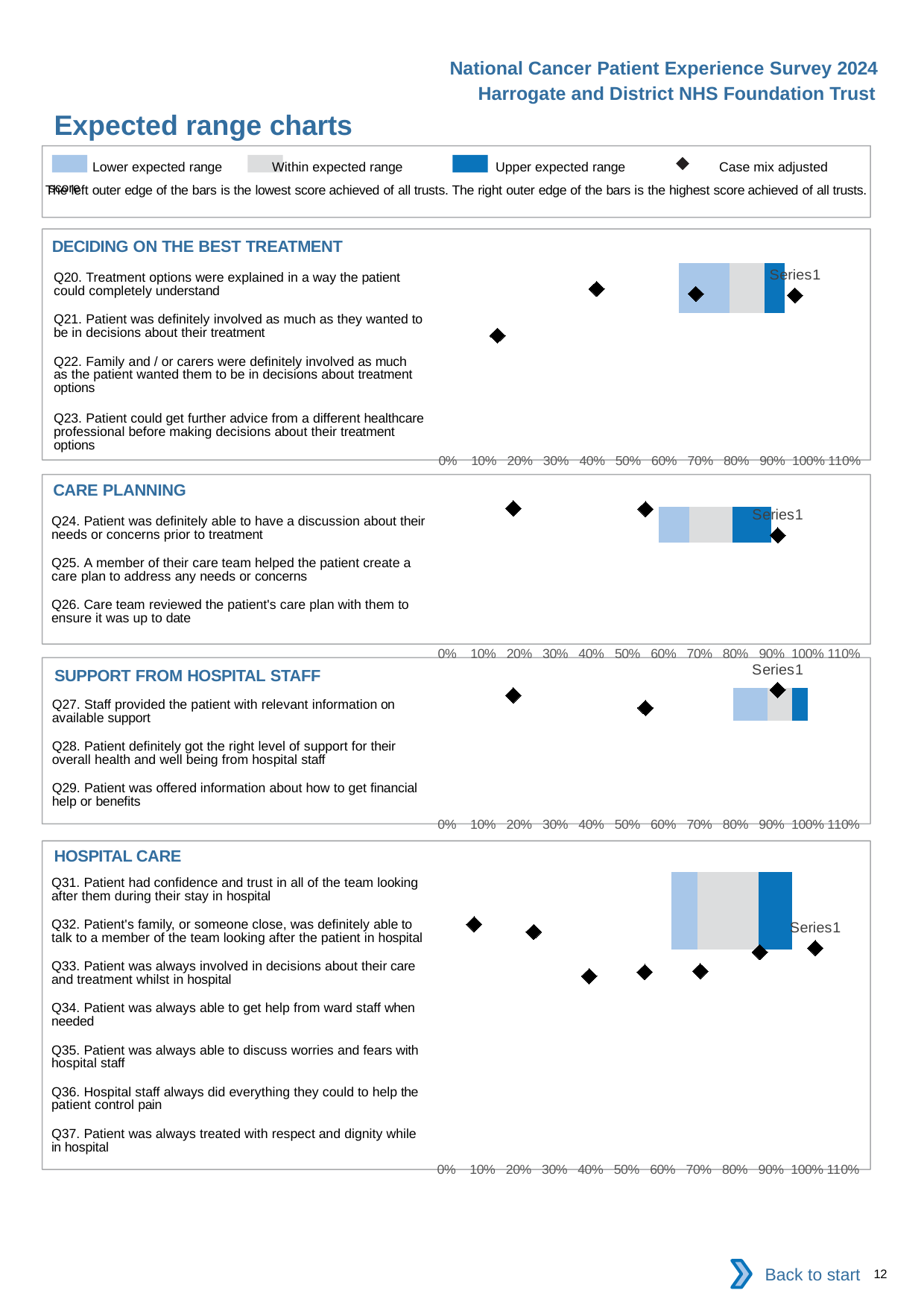
In the 'CARE PLANNING' chart, what is the interval between x-axis tick labels? 10% What is the first question listed in the 'CARE PLANNING' chart? Q24. Patient was definitely able to have a discussion about their needs or concerns prior to treatment In the 'DECIDING ON THE BEST TREATMENT' chart, how many questions are listed? 4 In the 'CARE PLANNING' chart, how many questions are listed? 3 In the 'HOSPITAL CARE' chart, how many questions are listed? 7 How many entries does the legend at the top of the slide list? 4 In the 'HOSPITAL CARE' chart, what is the highest value shown on the x axis? 110% What kind of chart is used in the 'DECIDING ON THE BEST TREATMENT' section? Bar chart